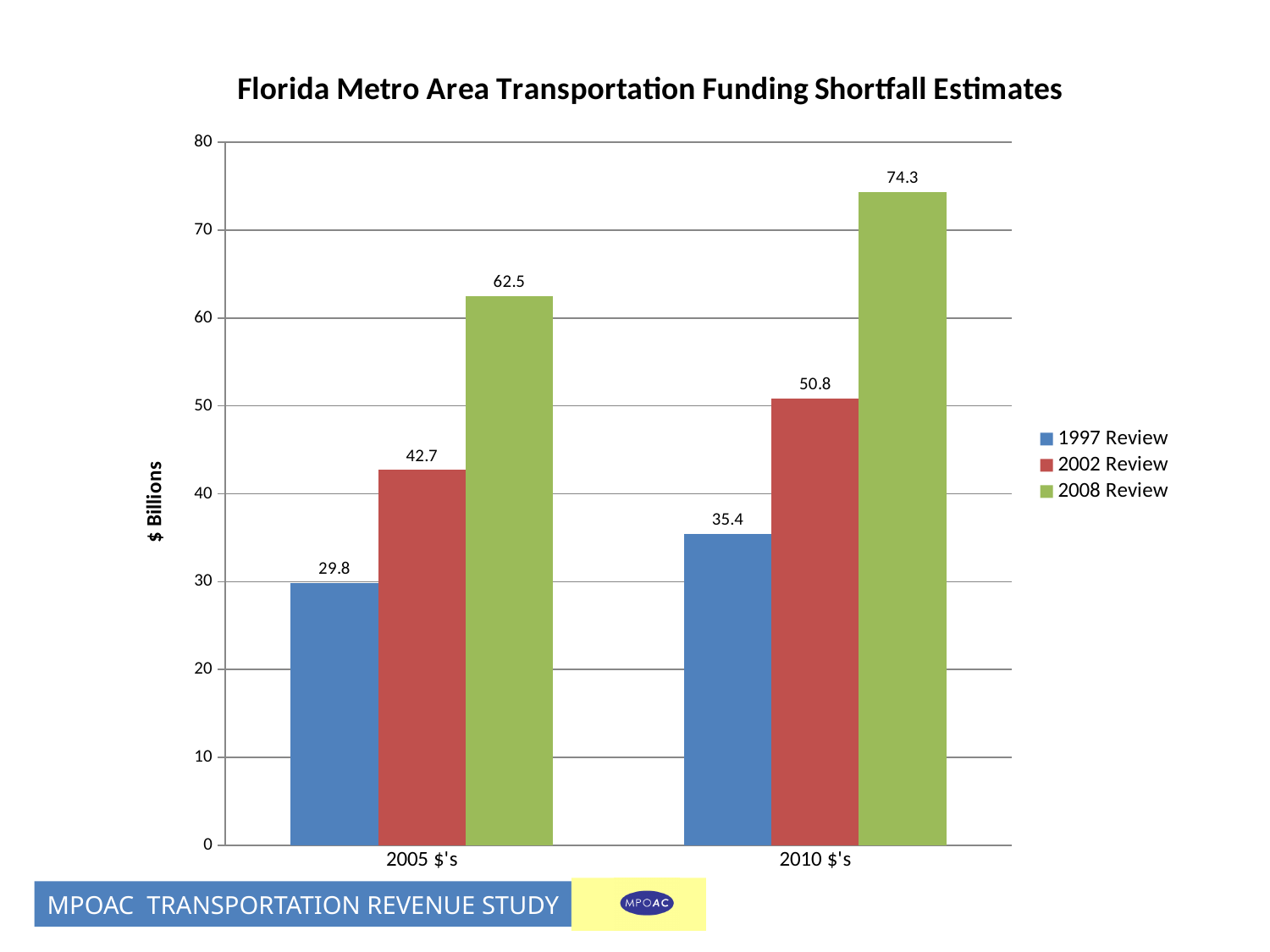
What is the value for the 2002 Review in 2010 $'s? 50.8 What kind of chart is shown on the slide? bar chart How many series does the legend list? 3 What is the difference between the 2002 Review values in 2010 $'s and 2005 $'s? 8.1 What is the value for the 1997 Review in 2005 $'s? 29.8 What is the value for the 2008 Review in 2010 $'s? 74.3 Which is larger: the 2002 Review value in 2005 $'s or the 1997 Review value in 2010 $'s? 2002 Review in 2005 $'s What is the difference between the 2008 Review and the 1997 Review values in 2010 $'s? 38.9 Which series has the lowest value in 2010 $'s? 1997 Review How many categories are shown on the x axis? 2 Is the value for the 2008 Review in 2005 $'s greater or less than 60? greater Which series has the highest value in 2005 $'s? 2008 Review